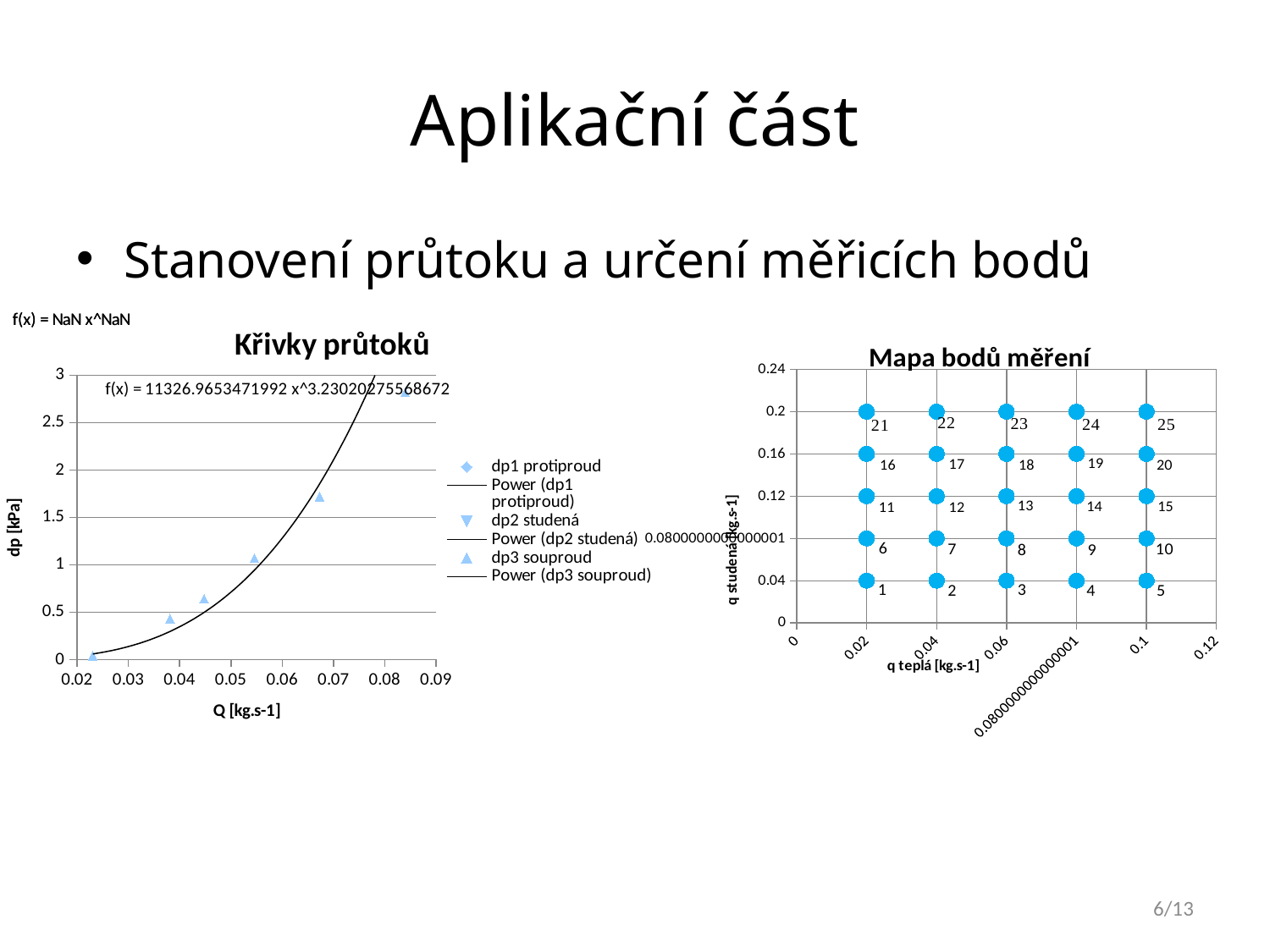
How many measurement points are plotted in "Mapa bodů měření"? 25 What kind of chart is "Křivky průtoků"? scatter chart In "Mapa bodů měření", what is the q teplá value of point 13? 0.06 In "Křivky průtoků", is the dp value of the plotted point near Q = 0.038 greater or less than 0.5? less In "Mapa bodů měření", which point has the higher q studená value, point 1 or point 21? point 21 In "Mapa bodů měření", what is the q studená value of point 25? 0.2 In "Křivky průtoků", do the plotted dp values rise or fall as Q increases? rise What is the title of the chart on the left of the slide? Křivky průtoků In "Křivky průtoků", is the dp value of the rightmost plotted point (near Q = 0.084) greater or less than 2.5? greater How many entries does the legend of "Křivky průtoků" list? 6 In "Mapa bodů měření", which point number is located at q teplá 0.1 and q studená 0.04? 5 What is the x-axis label of "Křivky průtoků"? Q [kg.s-1]